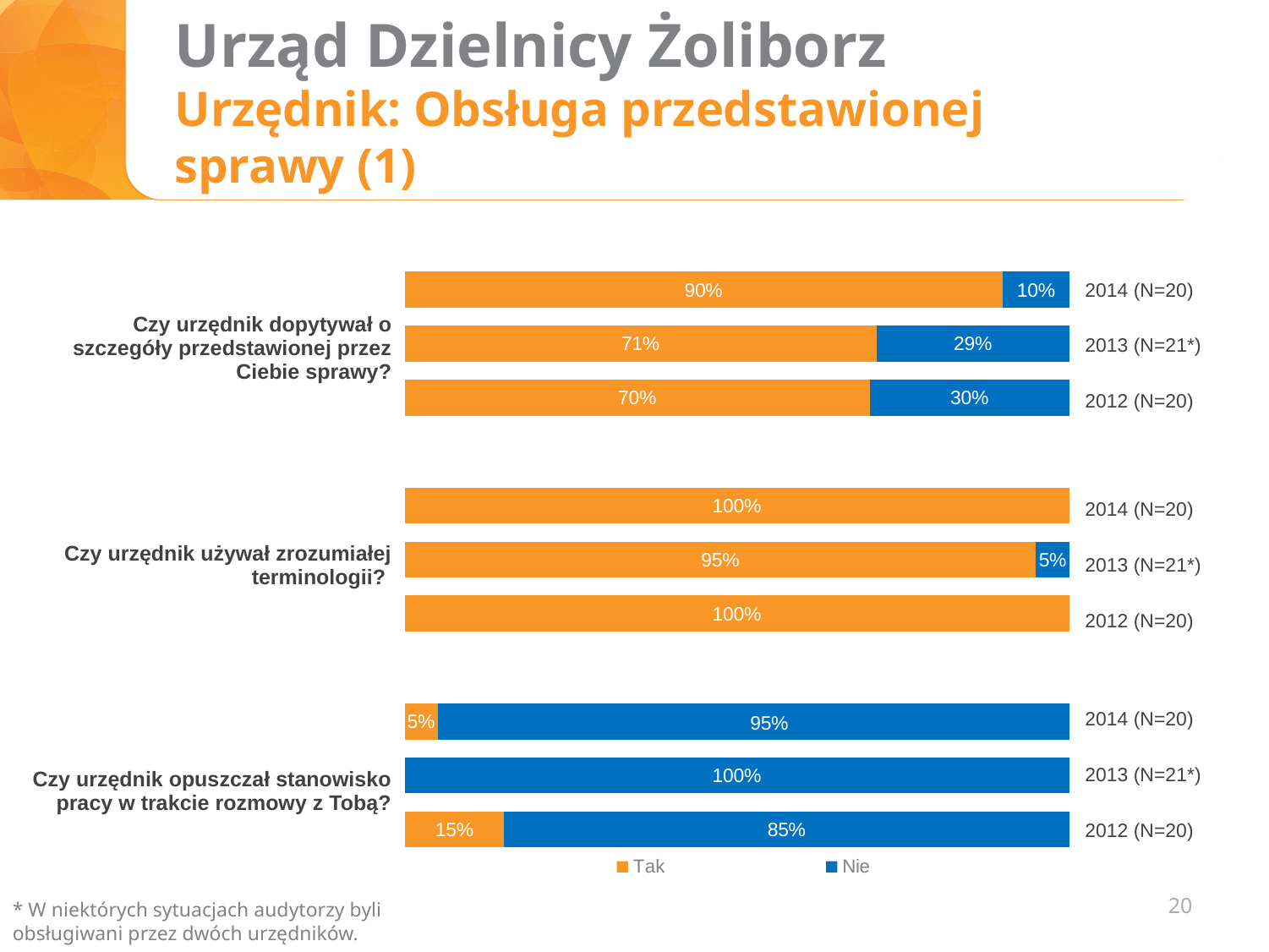
For "Czy urzędnik opuszczał stanowisko pracy w trakcie rozmowy z Tobą?", which is larger: the "Nie" share in 2014 or in 2012? 2014 What share answered "Nie" in 2013 to "Czy urzędnik używał zrozumiałej terminologii?"? 5% How did the "Tak" share for "Czy urzędnik dopytywał o szczegóły przedstawionej przez Ciebie sprawy?" change from 2012 to 2014? It rose Which colour represents the "Nie" answers in the chart? Blue What type of chart is shown on the slide? Stacked bar chart What share answered "Tak" in 2012 to "Czy urzędnik opuszczał stanowisko pracy w trakcie rozmowy z Tobą?"? 15% What share of respondents answered "Tak" in 2014 to the question "Czy urzędnik dopytywał o szczegóły przedstawionej przez Ciebie sprawy?"? 90% How many series does the legend list? 2 For "Czy urzędnik dopytywał o szczegóły przedstawionej przez Ciebie sprawy?", which year had the lowest "Tak" share? 2012 For "Czy urzędnik dopytywał o szczegóły przedstawionej przez Ciebie sprawy?", which year had the highest "Tak" share? 2014 By how many percentage points did the "Tak" share for "Czy urzędnik dopytywał o szczegóły przedstawionej przez Ciebie sprawy?" change from 2013 to 2014? 19 percentage points What share answered "Nie" in 2012 to "Czy urzędnik dopytywał o szczegóły przedstawionej przez Ciebie sprawy?"? 30%